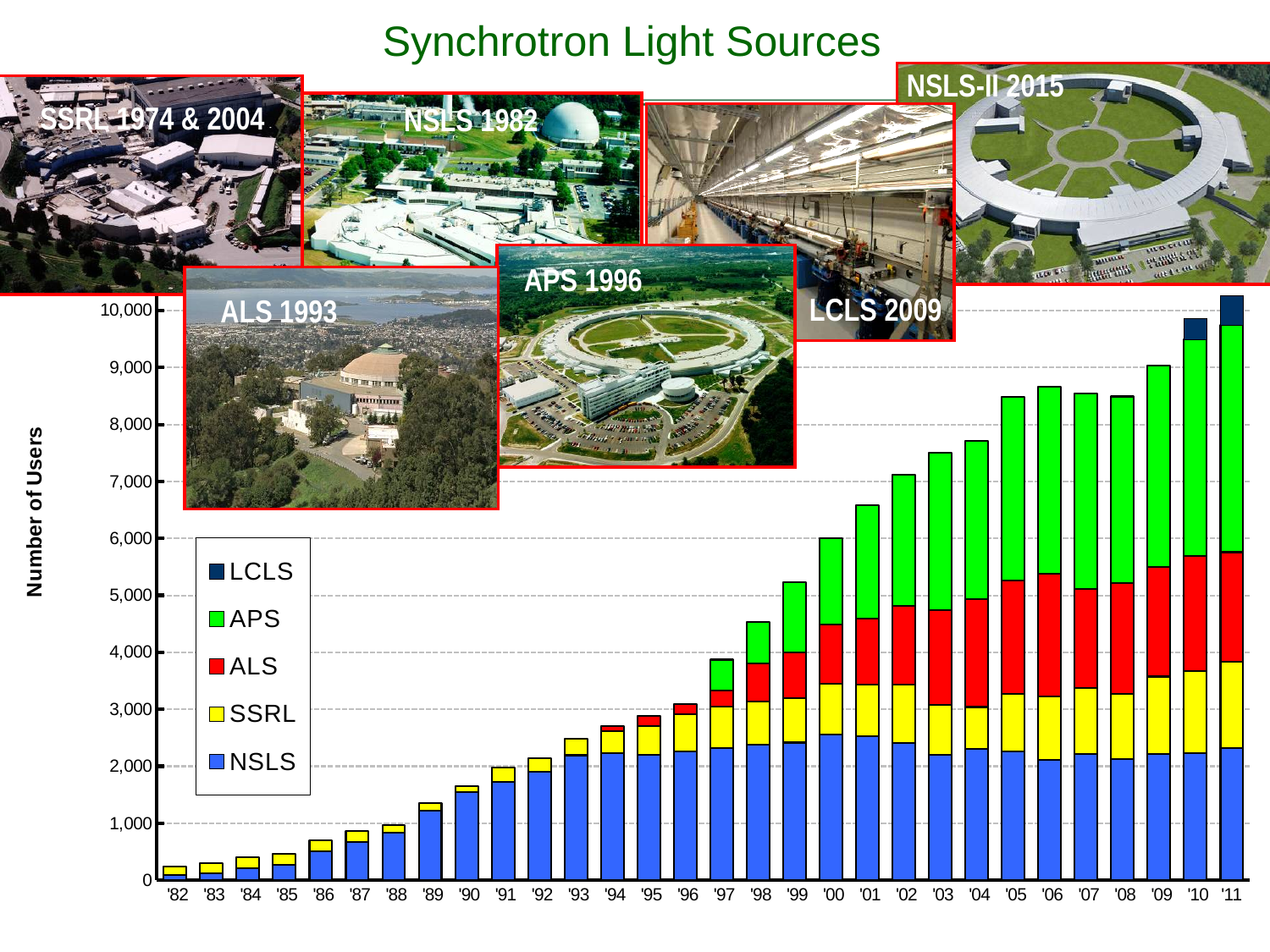
Is the total number of users for '05 greater or less than 8,000? greater Which year has a taller stacked bar, '04 or '05? '05 Is the total number of users for '86 greater or less than 1,000? less How many years are shown along the x axis of the chart? 30 What is the label on the chart's vertical axis? Number of Users Is the total number of users for '11 greater or less than 10,000? greater What kind of chart is shown on the slide? stacked bar chart Which year has the tallest stacked bar in the chart? '11 Do the total number of users generally rise or fall from '82 to '11? rise Which year has the shortest stacked bar in the chart? '82 How many series does the chart's legend list? 5